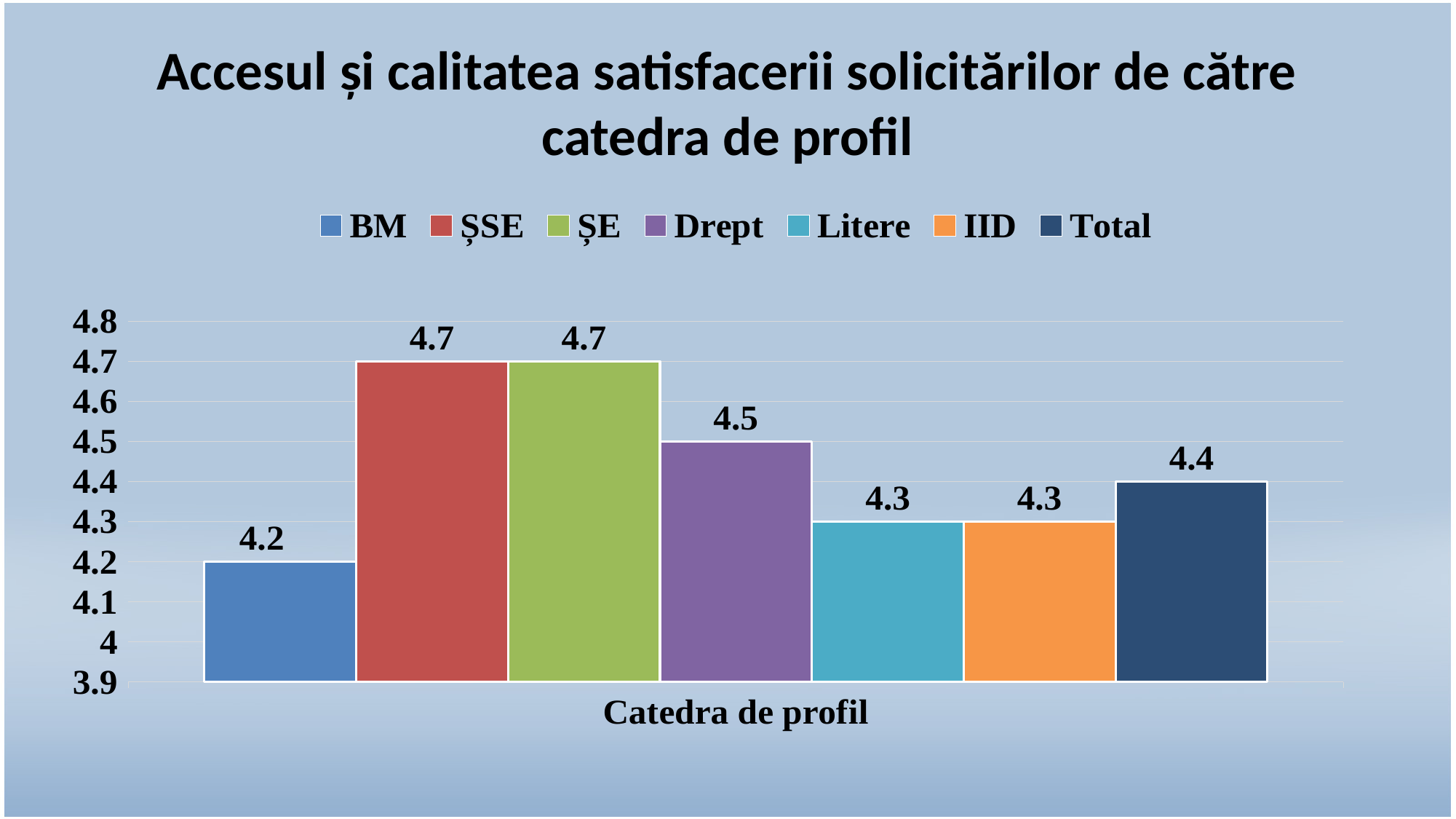
What is the value for Drept? 4.5 Is the value for ȘE greater or less than 4.5? greater What is the difference between the values for Drept and Total? 0.1 What is the value for BM? 4.2 How many series does the legend list? 7 What kind of chart is shown on the slide? bar chart What is the value for Litere? 4.3 What is the difference between the values for ȘSE and BM? 0.5 What is the value for Total? 4.4 Which is larger, the value for Drept or the value for IID? Drept Which series has the lowest value? BM What is the label of the horizontal axis? Catedra de profil